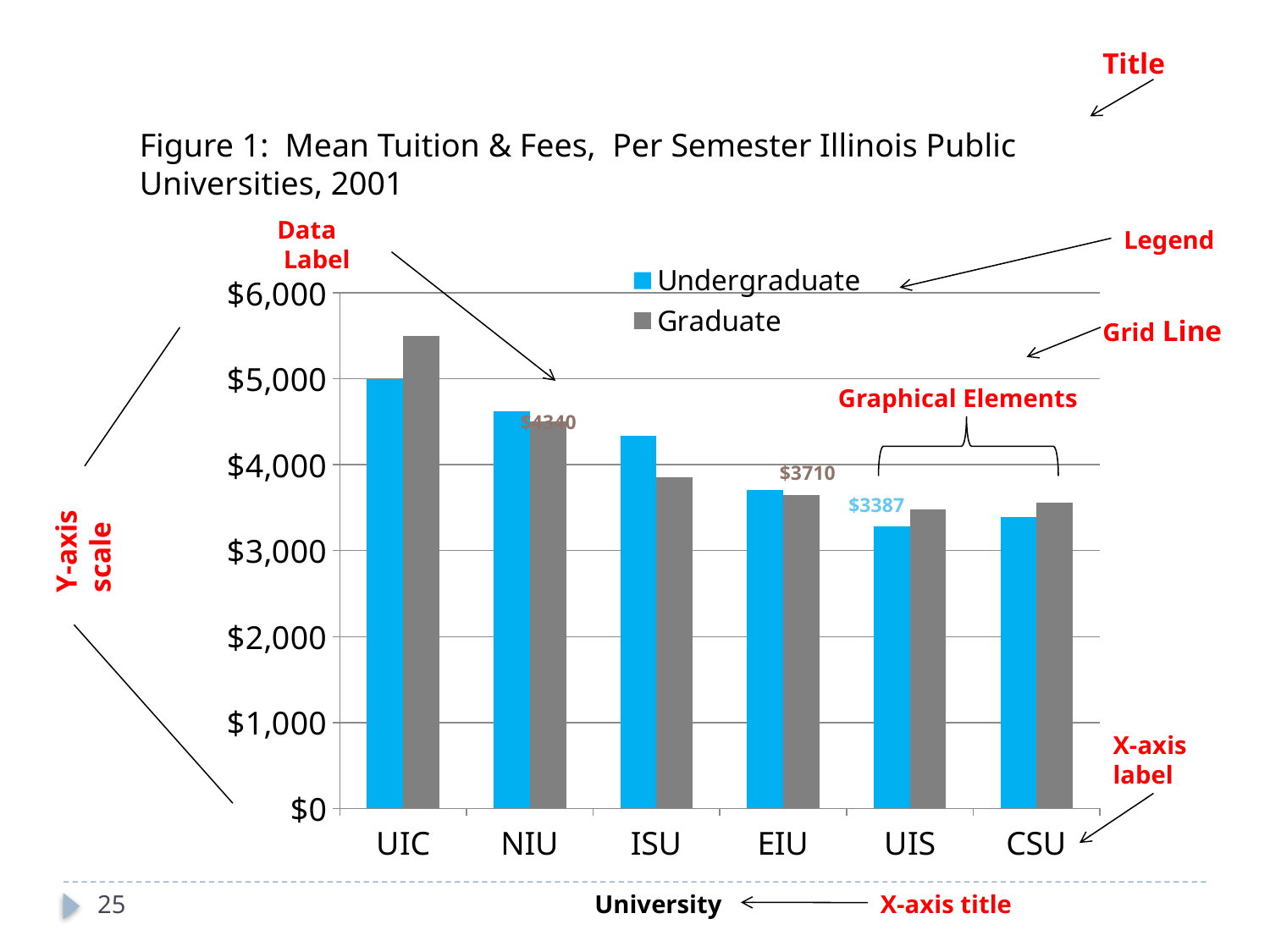
Which university has the highest Graduate tuition and fees? UIC What kind of chart is shown on the slide? bar chart Which university has the highest Undergraduate tuition and fees? UIC At UIC, which is larger: the Undergraduate or the Graduate value? Graduate Is the Undergraduate value for NIU greater or less than $4,000? greater What is the Undergraduate value labelled for UIS? $3387 How many universities are shown on the x-axis? 6 How many series does the legend list? 2 Is the Graduate value for UIC greater or less than $5,000? greater At ISU, which is larger: the Undergraduate or the Graduate value? Undergraduate Is the Graduate value for ISU greater or less than $4,000? less What is the title of the x-axis? University